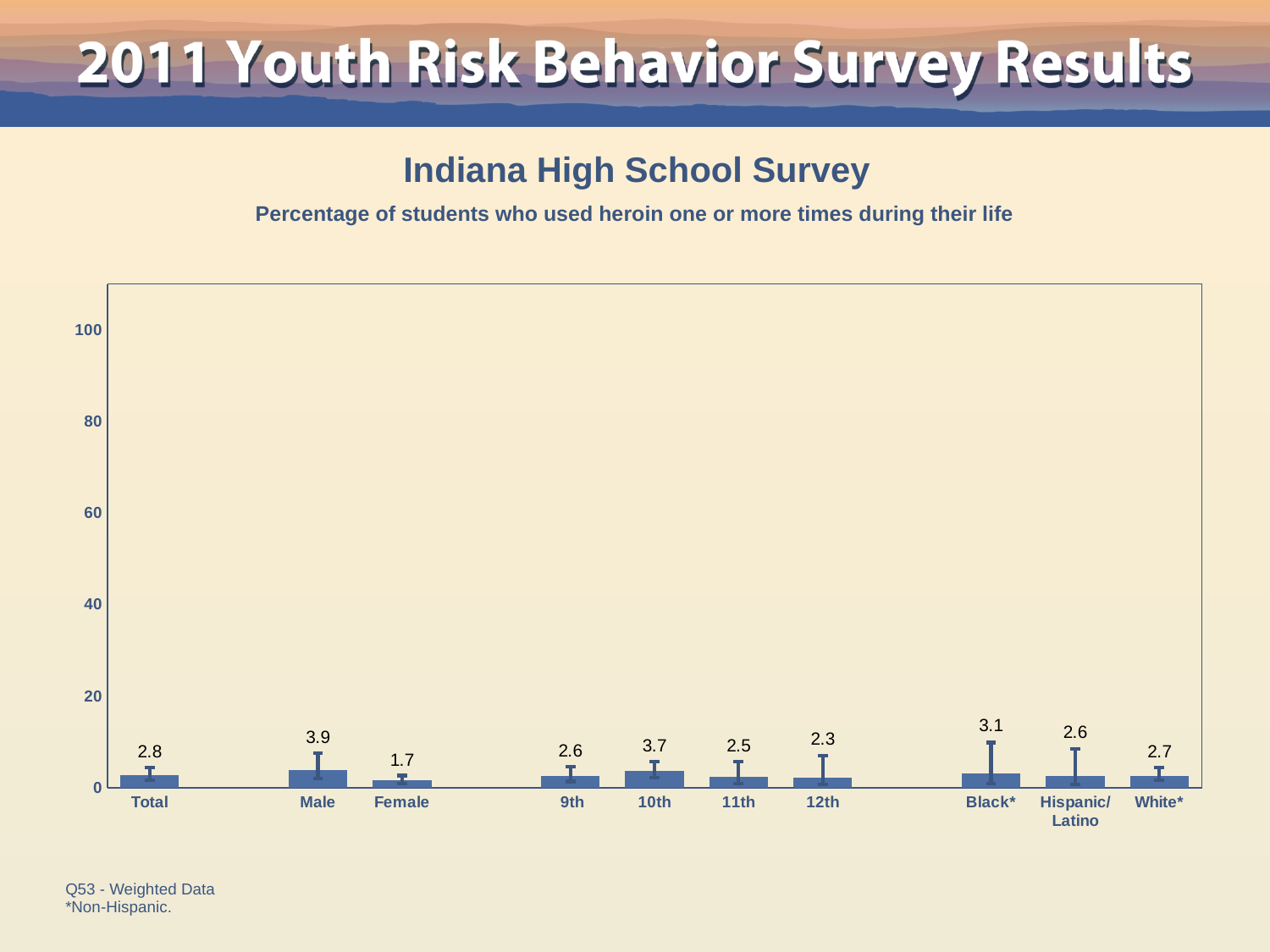
What is the chart's subtitle describing the measured percentage? Percentage of students who used heroin one or more times during their life How many categories are shown on the x axis? 10 What is the value for Hispanic/Latino? 2.6 What is the difference between the Male and Female values? 2.2 What is the value for 10th grade? 3.7 Which is larger, the value for Black* or the value for White*? Black* What is the value for Female? 1.7 What is the value for Total? 2.8 What kind of chart is this? bar chart Which category has the lowest value? Female Is the value for 12th grade greater or less than 20? less Which category has the highest value? Male